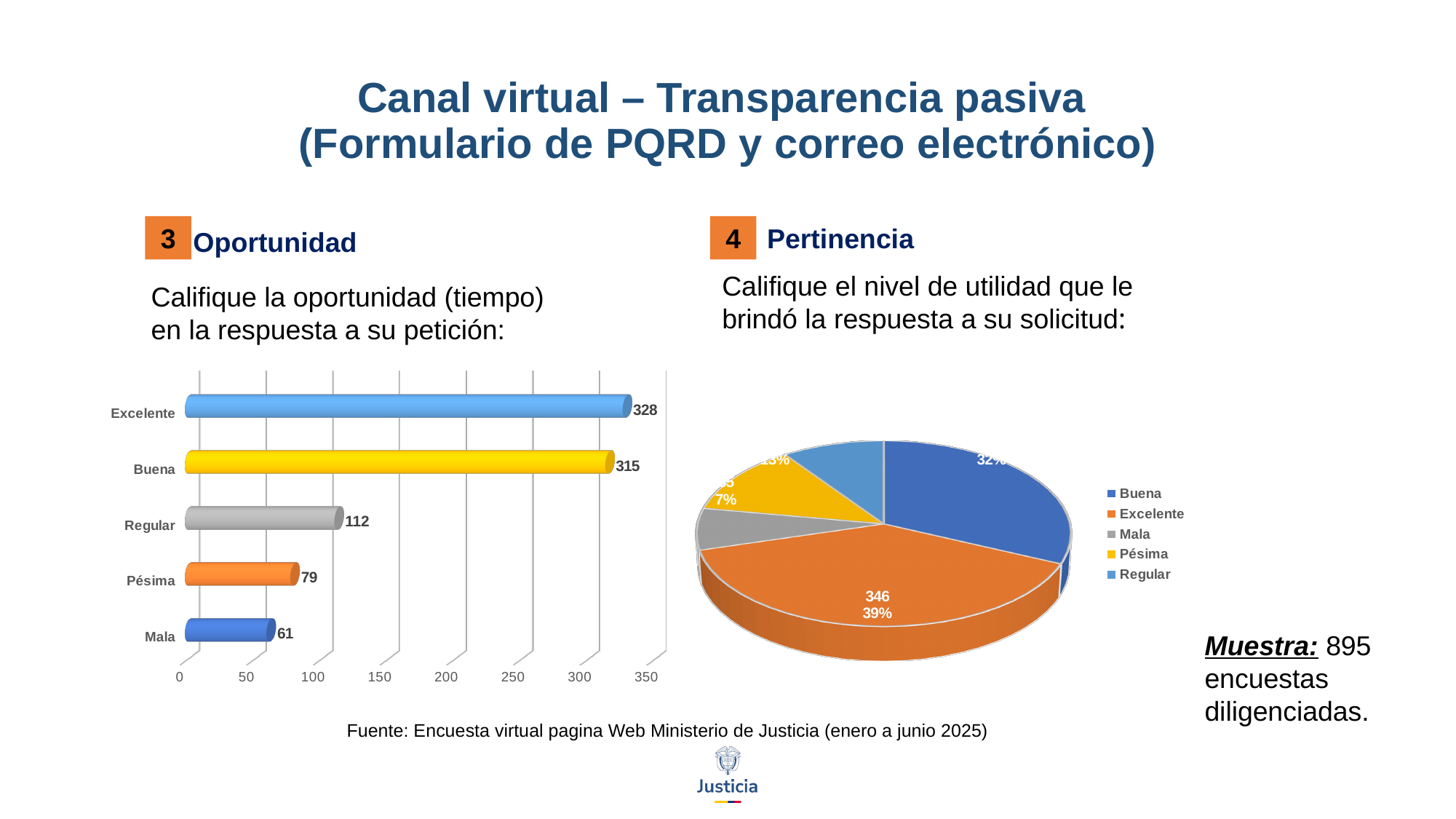
In the Pertinencia pie chart, what is the value shown for the Excelente slice? 346 How many categories are shown in the Oportunidad bar chart? 5 What kind of chart is used for the Oportunidad question? Bar chart In the Pertinencia pie chart, what share does the Excelente slice represent? 39% In the Oportunidad bar chart, which is larger, the value for Regular or the value for Pésima? Regular In the Oportunidad bar chart, what is the value for Excelente? 328 In the Oportunidad bar chart, which category has the lowest value? Mala In the Oportunidad bar chart, what is the difference between the values for Excelente and Buena? 13 In the Oportunidad bar chart, which category has the highest value? Excelente In the Oportunidad bar chart, what is the value for Regular? 112 How many entries does the legend of the Pertinencia pie chart list? 5 In the Oportunidad bar chart, what is the value for Mala? 61